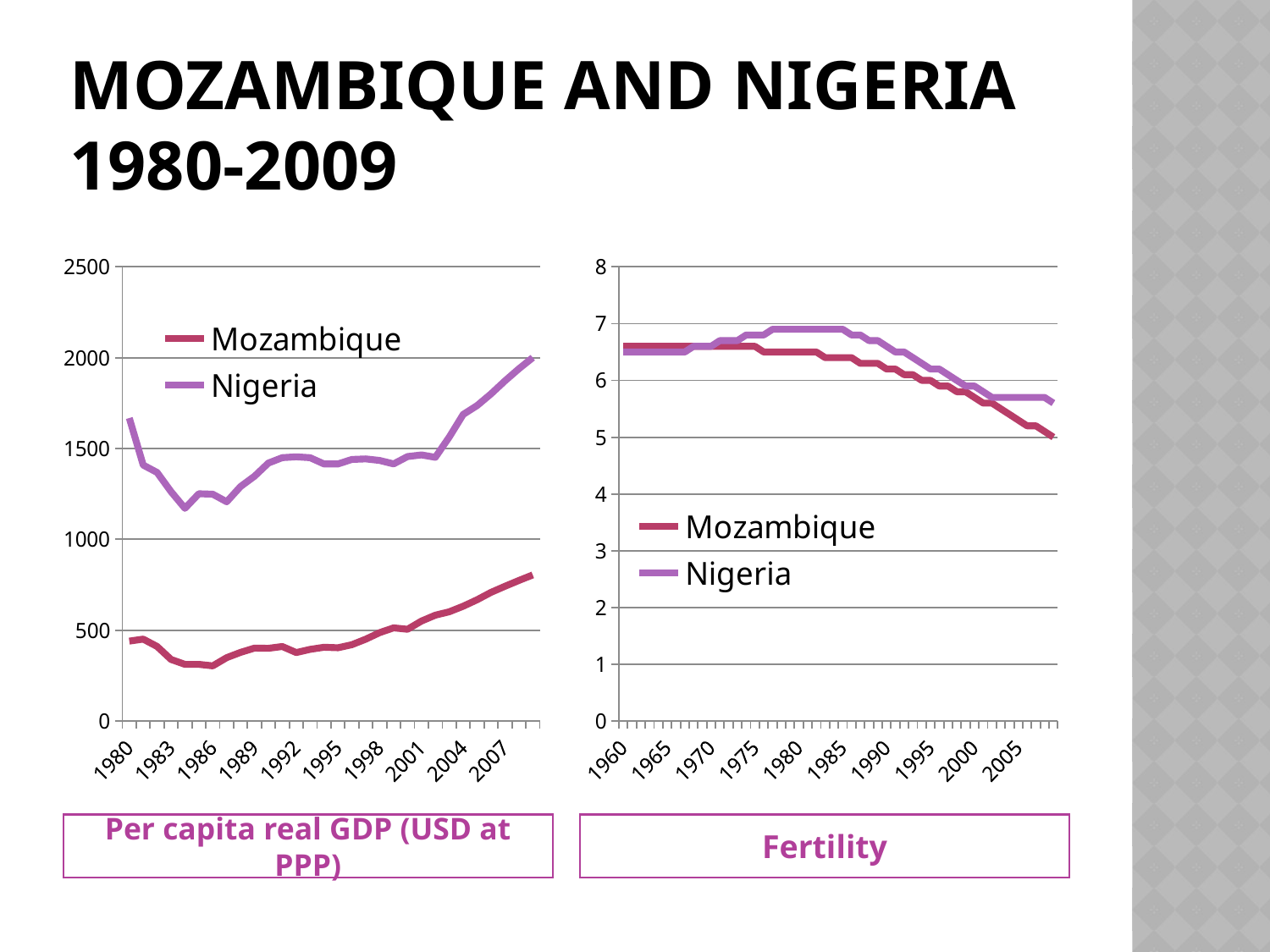
In the Per capita real GDP (USD at PPP) chart, does the Mozambique line rise or fall between 1995 and 2009? rise What kind of chart is the Fertility chart on the right? line chart Which two countries are listed in the legend of the Fertility chart? Mozambique and Nigeria How many series does the legend of the Fertility chart list? 2 In the Fertility chart, is the value for Mozambique at the end of the series greater or less than 6? less How many series does the legend of the Per capita real GDP (USD at PPP) chart list? 2 In the Per capita real GDP (USD at PPP) chart, is the value for Nigeria in 1980 greater or less than 1500? greater In the Per capita real GDP (USD at PPP) chart, is the value for Mozambique at the end of the series (2009) greater or less than 1000? less In the Fertility chart, does the Nigeria line rise or fall between 1985 and 2005? fall In the Per capita real GDP (USD at PPP) chart, which country has the higher value in 1980, Mozambique or Nigeria? Nigeria What kind of chart is the Per capita real GDP (USD at PPP) chart on the left? line chart